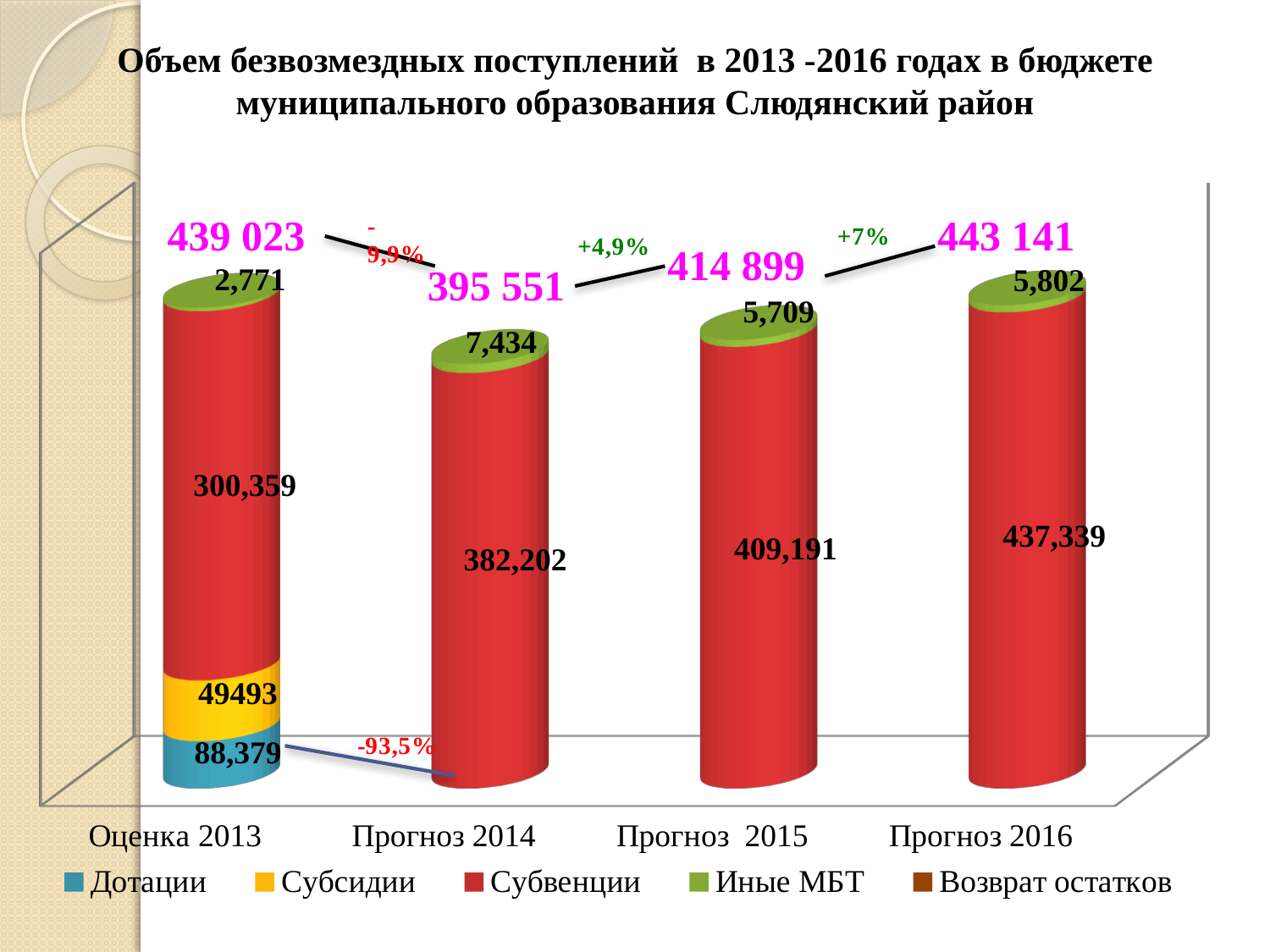
What is the total shown above the bar for Прогноз 2015? 414 899 What kind of chart is shown on the slide? Stacked bar chart What is the value of Дотации for Оценка 2013? 88,379 How many series does the legend list? 5 What is the difference between the Субвенции values for Прогноз 2016 and Прогноз 2015? 28,148 How many categories are shown on the x axis? 4 Which is larger: Иные МБТ for Прогноз 2014 or for Прогноз 2015? Прогноз 2014 What is the value of Иные МБТ for Прогноз 2014? 7,434 What is the value of Субвенции for Прогноз 2016? 437,339 Which category has the lowest Субвенции value? Оценка 2013 Which category has the highest Субвенции value? Прогноз 2016 What is the value of Субсидии for Оценка 2013? 49493